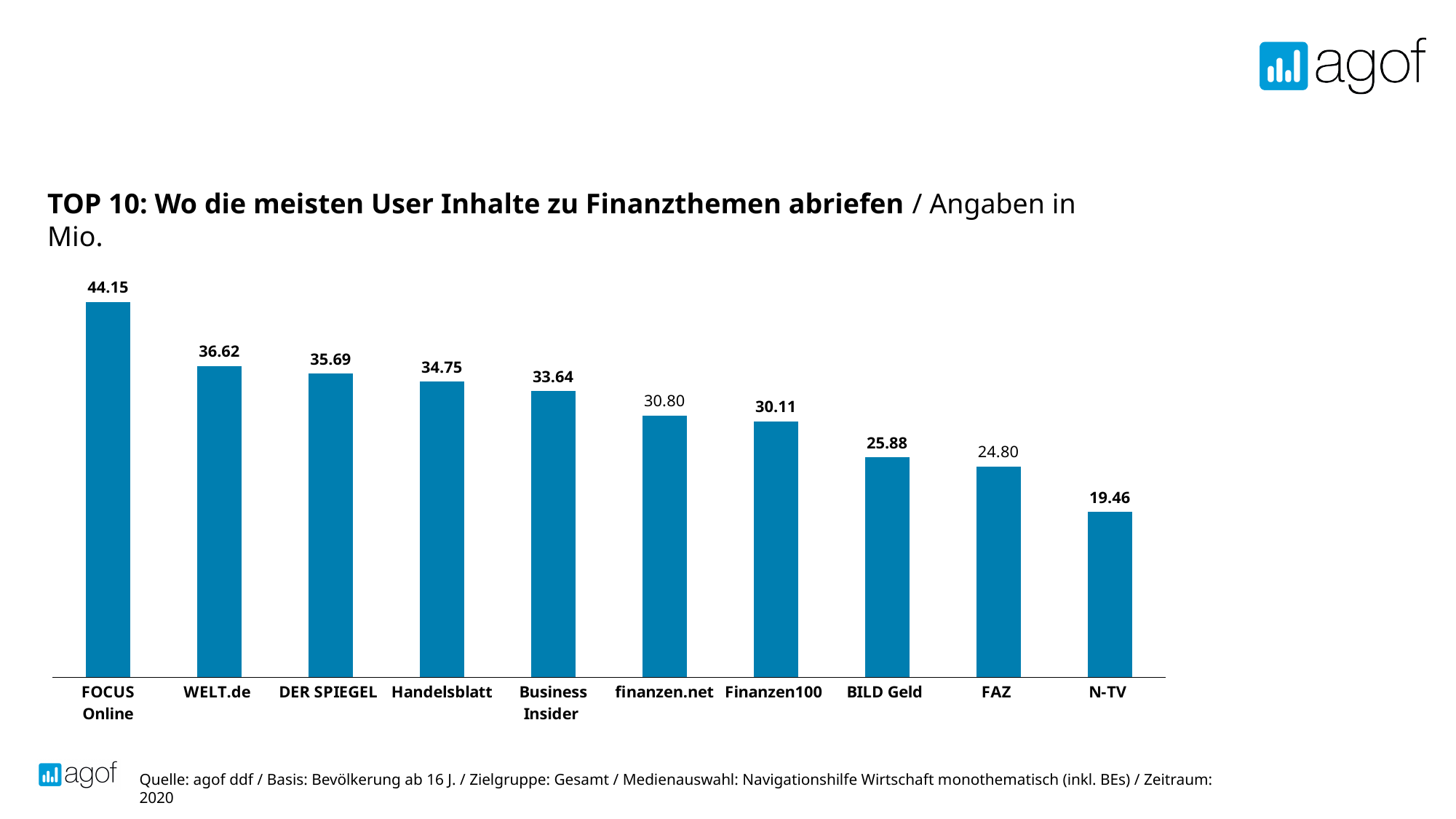
What is the difference between the values for FOCUS Online and WELT.de? 7.53 What is the value for BILD Geld? 25.88 Do the values rise or fall from left to right along the x axis? Fall Which category has the highest value? FOCUS Online Which has a larger value, DER SPIEGEL or FAZ? DER SPIEGEL What is the value for N-TV? 19.46 What kind of chart is shown on the slide? Bar chart What is the difference between the values for finanzen.net and Finanzen100? 0.69 What is the value for Handelsblatt? 34.75 What is the value for FOCUS Online? 44.15 Which category has the lowest value? N-TV How many categories are shown in the chart? 10